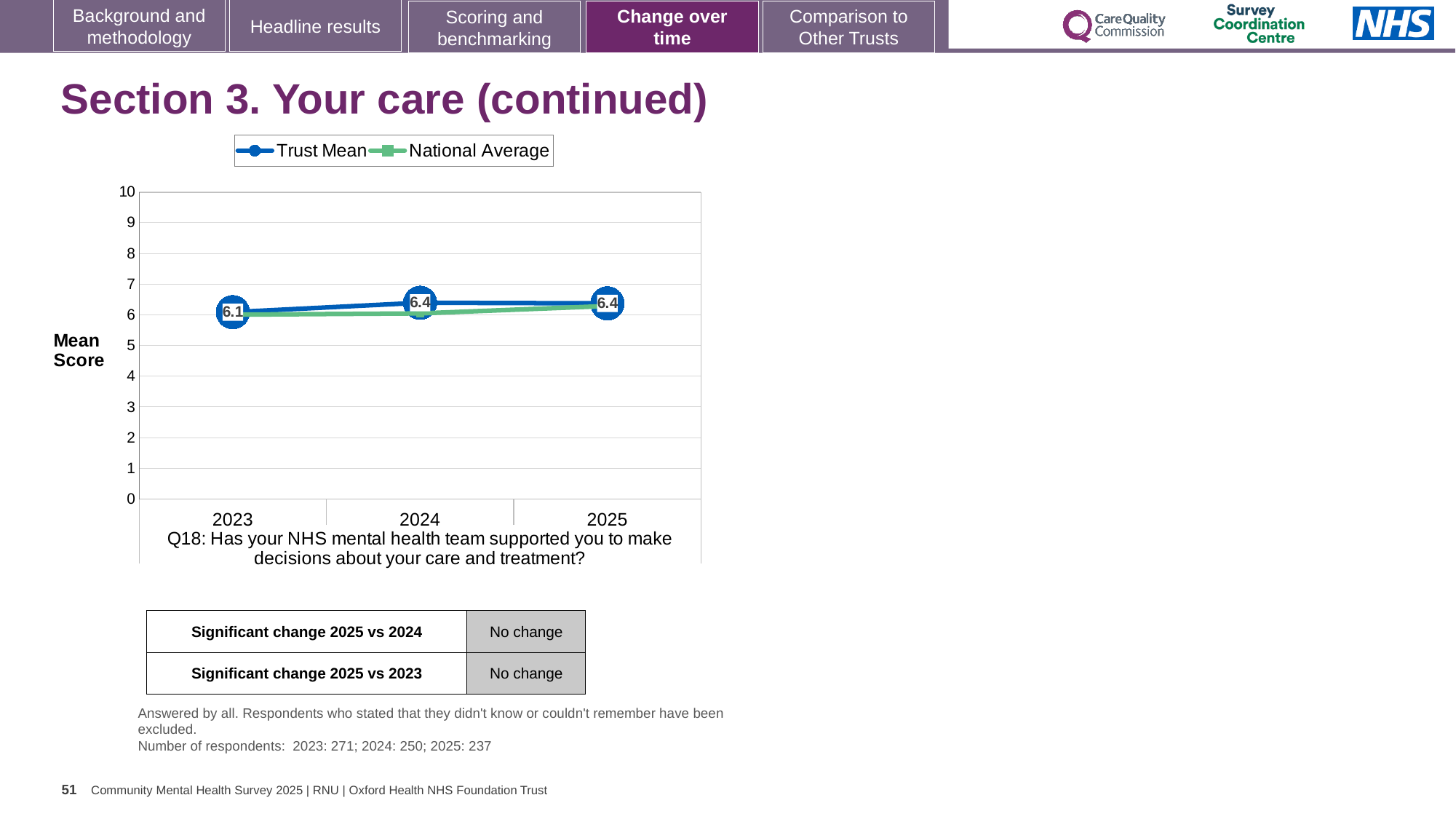
In which year is the Trust Mean lowest? 2023 Is the Trust Mean for 2024 larger or smaller than the Trust Mean for 2023? larger What is the Trust Mean value for 2023? 6.1 What kind of chart is shown on the slide? line chart Is the National Average value for 2025 greater or less than 5? greater What is the difference between the Trust Mean in 2024 and in 2023? 0.3 How many years are shown on the x axis of the chart? 3 Is the National Average value for 2023 greater or less than 7? less What is the Trust Mean value for 2025? 6.4 How many series does the chart legend list? 2 What is the Trust Mean value for 2024? 6.4 What is the label on the y axis of the chart? Mean Score